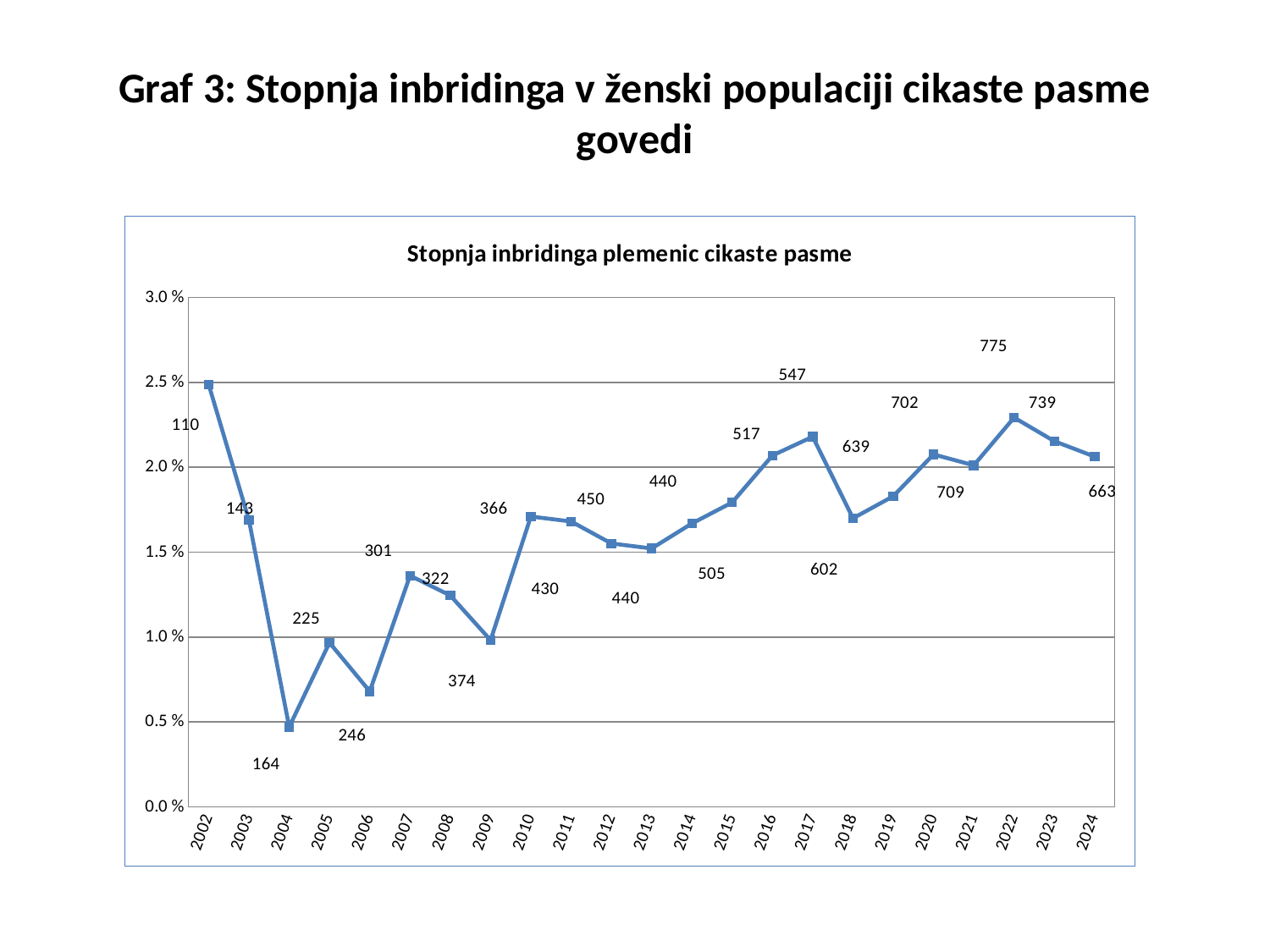
Is the value for 2017 greater or less than 2.0 %? greater What number is printed as the data label next to the 2022 point? 775 In which year does the line reach its lowest value? 2004 What kind of chart is shown on the slide? line chart How many years are plotted along the x axis of the chart? 23 Is the value for 2002 greater or less than 2.0 %? greater What is the title printed inside the chart area? Stopnja inbridinga plemenic cikaste pasme Is the value for 2004 greater or less than 1.0 %? less Which year has the higher plotted value, 2004 or 2006? 2006 Does the line rise or fall between 2013 and 2017? rise In which year does the line reach its highest value? 2002